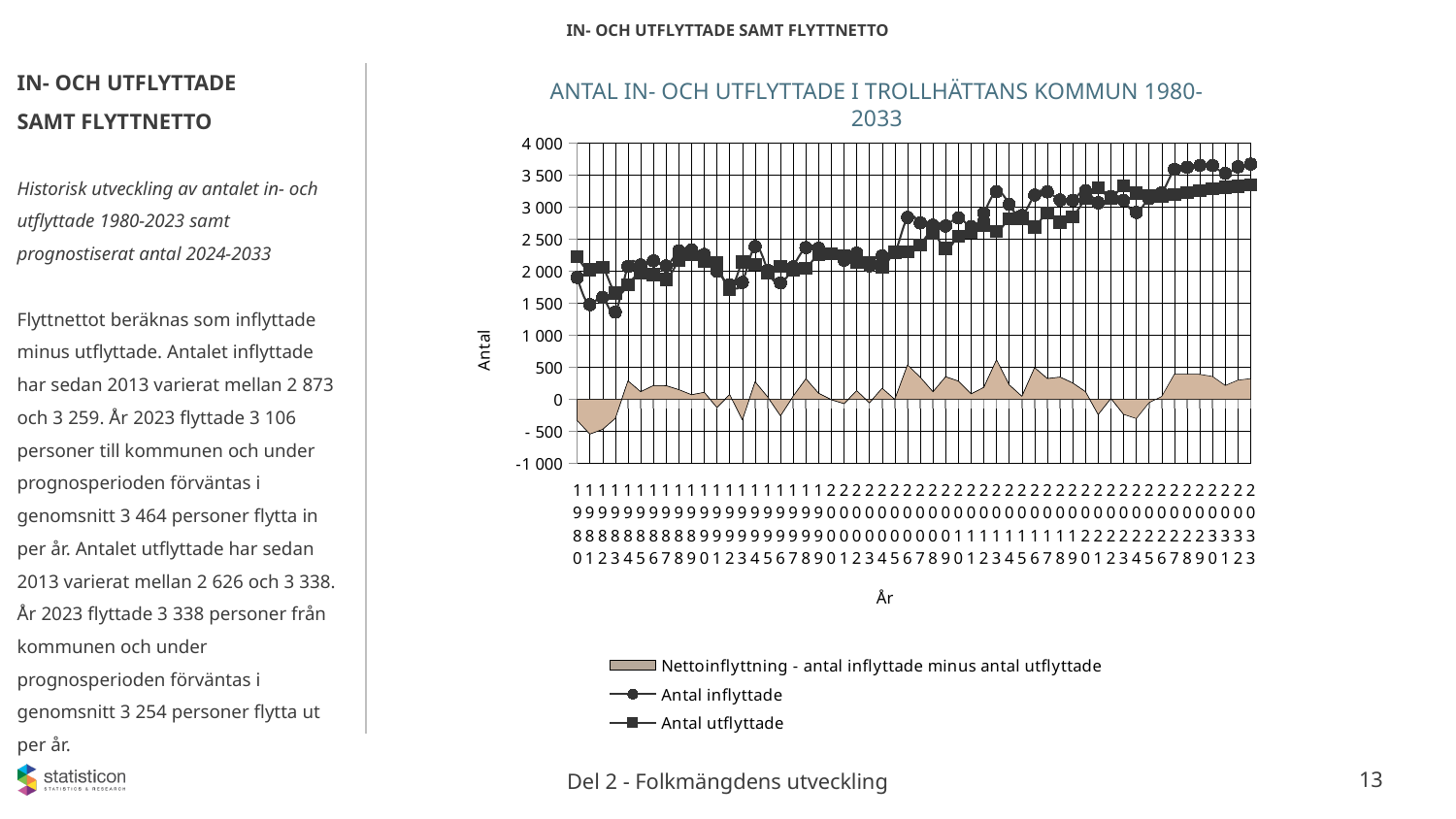
How many years are plotted along the x axis of the chart? 54 Is the value of Antal inflyttade in 2033 greater or less than 3 500? greater Is the value of Nettoinflyttning in 1981 greater or less than 0? less How many series does the legend of the chart list? 3 In 2033, which is larger: Antal inflyttade or Antal utflyttade? Antal inflyttade What is the title of the chart? ANTAL IN- OCH UTFLYTTADE I TROLLHÄTTANS KOMMUN 1980-2033 Is the value of Antal inflyttade in 1983 greater or less than 1 500? less Which series is shown as a shaded area in the chart? Nettoinflyttning - antal inflyttade minus antal utflyttade What kind of chart is shown on the slide? Line chart (with a shaded area series) In 1980, which is larger: Antal inflyttade or Antal utflyttade? Antal utflyttade Does Antal utflyttade generally rise or fall from 1980 to 2033? rise